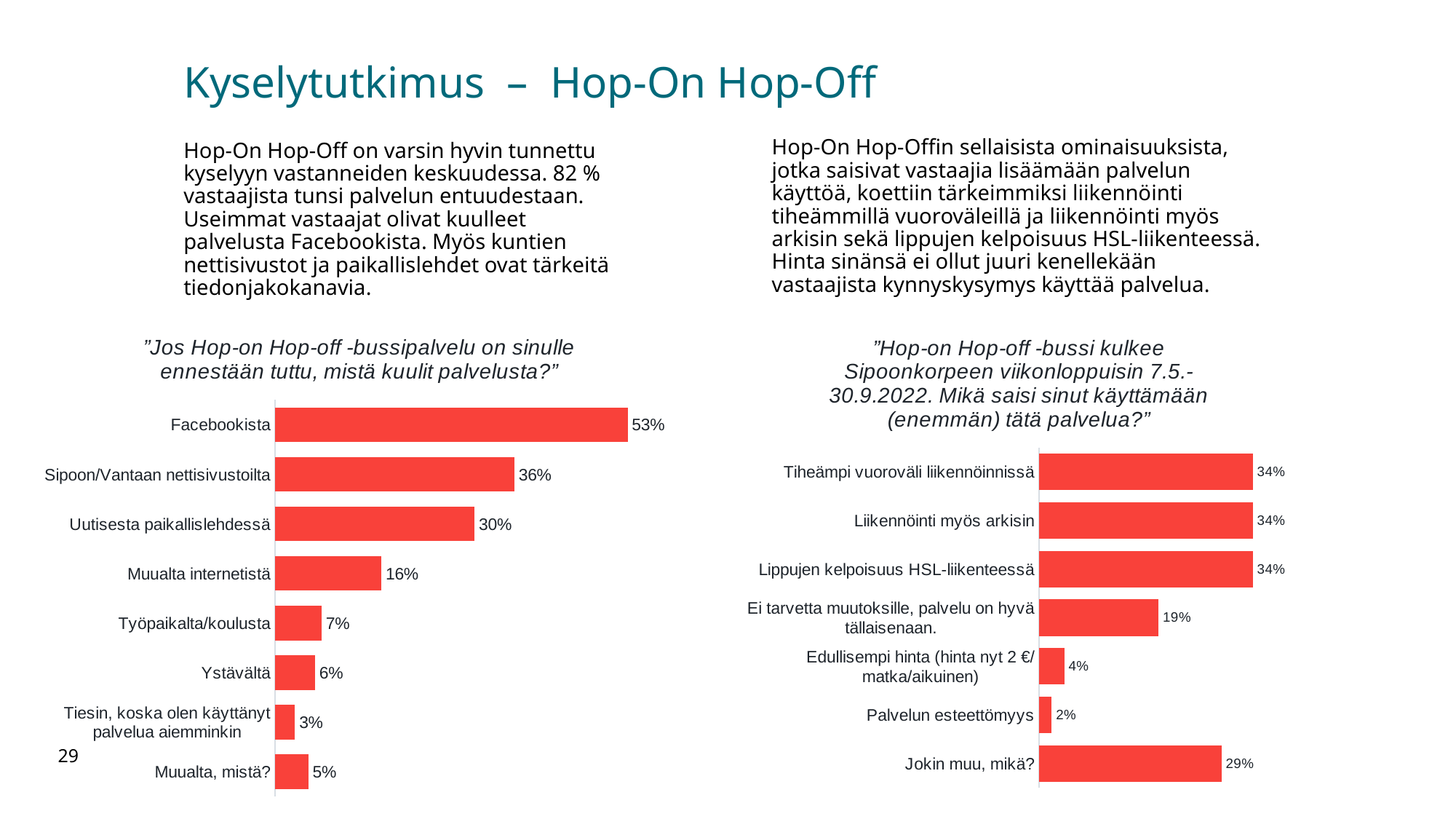
In the left chart, which category has the highest value? Facebookista In the right chart, which is larger: Edullisempi hinta or Palvelun esteettömyys? Edullisempi hinta In the right chart, what is the value for Jokin muu, mikä? 29% In the left chart, how many categories are shown? 8 In the left chart ("Jos Hop-on Hop-off -bussipalvelu on sinulle ennestään tuttu, mistä kuulit palvelusta?"), what is the value for Facebookista? 53% What type of chart is the left chart? Bar chart In the right chart, how many categories are shown? 7 In the right chart, which category has the lowest value? Palvelun esteettömyys In the left chart, what is the difference between Facebookista and Sipoon/Vantaan nettisivustoilta? 17% In the left chart, what is the value for Uutisesta paikallislehdessä? 30% In the right chart ("Hop-on Hop-off -bussi kulkee Sipoonkorpeen..."), what is the value for Ei tarvetta muutoksille, palvelu on hyvä tällaisenaan? 19% In the left chart, which category has the lowest value? Tiesin, koska olen käyttänyt palvelua aiemminkin